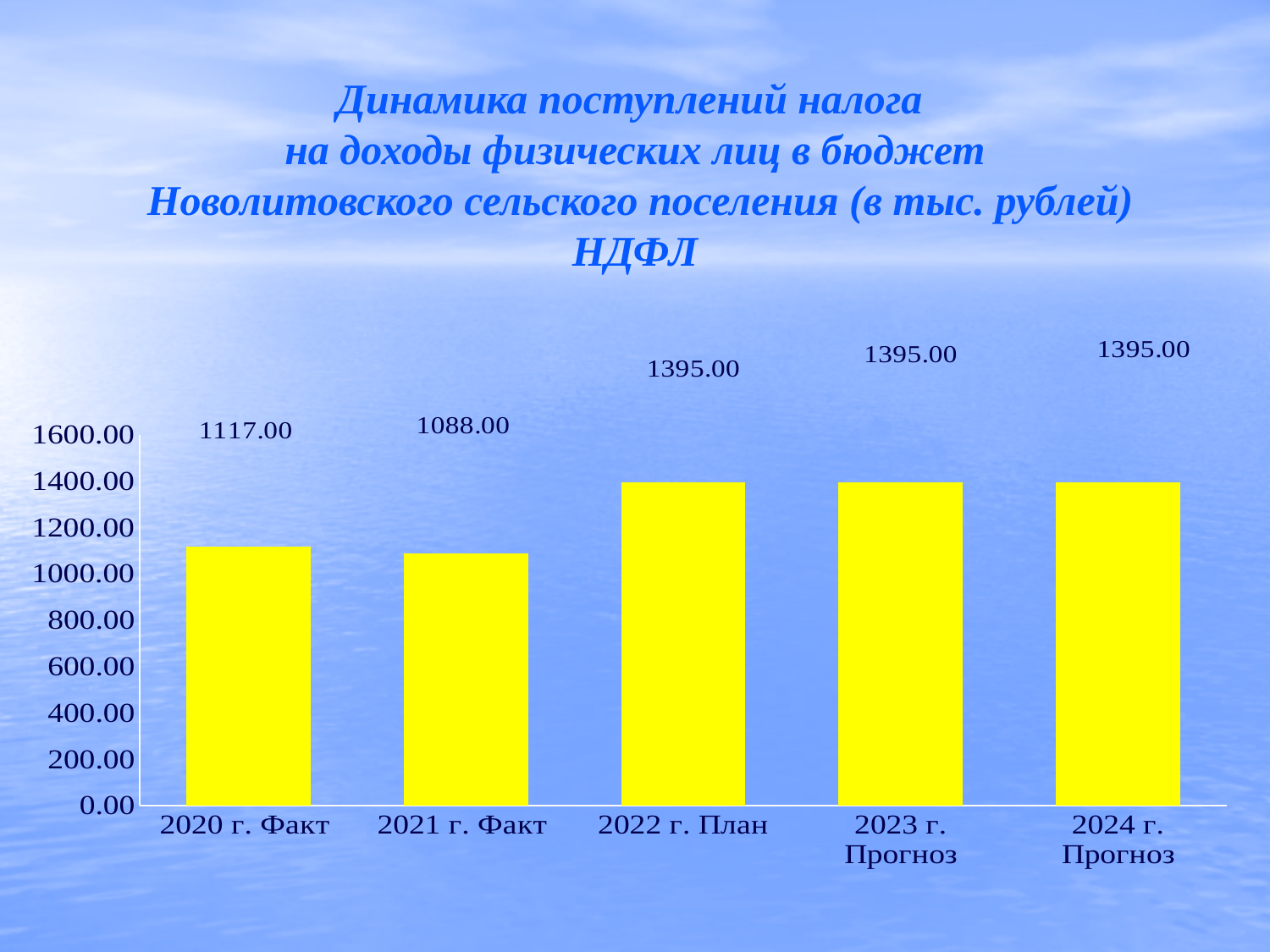
What is the value for 2022 г. План? 1395.00 What is the value for 2021 г. Факт? 1088.00 How many categories are shown on the x axis? 5 What is the value for 2020 г. Факт? 1117.00 What is the value for 2024 г. Прогноз? 1395.00 What kind of chart is shown on the slide? Bar chart What is the difference between the values for 2020 г. Факт and 2021 г. Факт? 29.00 What is the difference between the values for 2022 г. План and 2021 г. Факт? 307.00 Which is larger, the value for 2020 г. Факт or the value for 2021 г. Факт? 2020 г. Факт Is the value for 2023 г. Прогноз greater or less than 1200.00? greater What colour are the bars in the chart? Yellow Which category has the lowest value? 2021 г. Факт